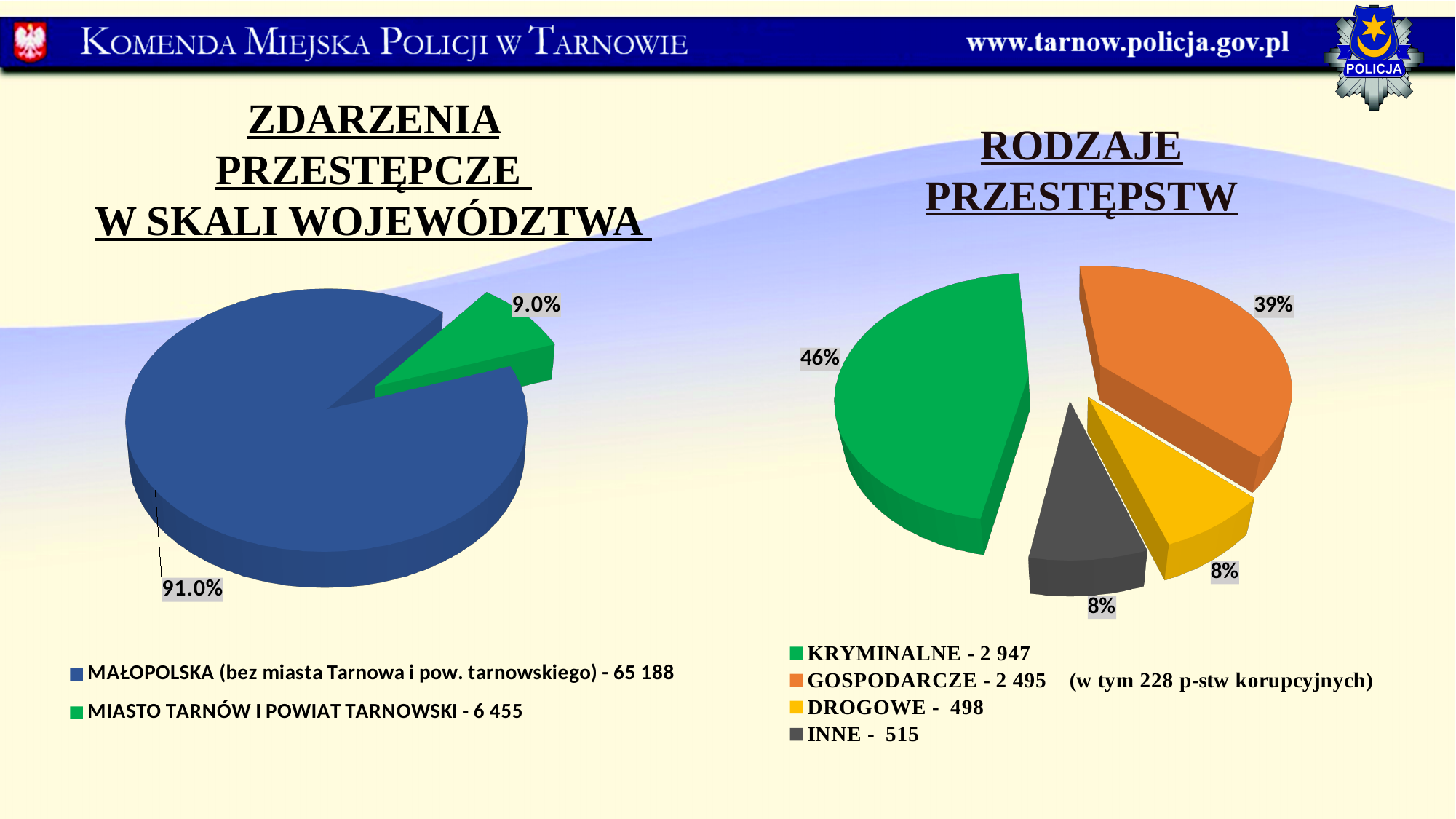
In the left chart (ZDARZENIA PRZESTĘPCZE W SKALI WOJEWÓDZTWA), what value does the legend give for MIASTO TARNÓW I POWIAT TARNOWSKI? 6 455 In the left chart (ZDARZENIA PRZESTĘPCZE W SKALI WOJEWÓDZTWA), what value does the legend give for MAŁOPOLSKA (bez miasta Tarnowa i pow. tarnowskiego)? 65 188 In the right chart (RODZAJE PRZESTĘPSTW), what value does the legend give for INNE? 515 In the right chart (RODZAJE PRZESTĘPSTW), what percentage share is shown for KRYMINALNE? 46% What kind of chart is the left chart (ZDARZENIA PRZESTĘPCZE W SKALI WOJEWÓDZTWA)? Pie chart In the right chart (RODZAJE PRZESTĘPSTW), what percentage share is shown for GOSPODARCZE? 39% In the right chart (RODZAJE PRZESTĘPSTW), how many categories does the legend list? 4 In the left chart (ZDARZENIA PRZESTĘPCZE W SKALI WOJEWÓDZTWA), what percentage share is shown for MIASTO TARNÓW I POWIAT TARNOWSKI? 9.0% In the right chart (RODZAJE PRZESTĘPSTW), which category has the largest share? KRYMINALNE In the right chart (RODZAJE PRZESTĘPSTW), what is the difference between the values for KRYMINALNE and GOSPODARCZE? 452 In the right chart (RODZAJE PRZESTĘPSTW), what value does the legend give for DROGOWE? 498